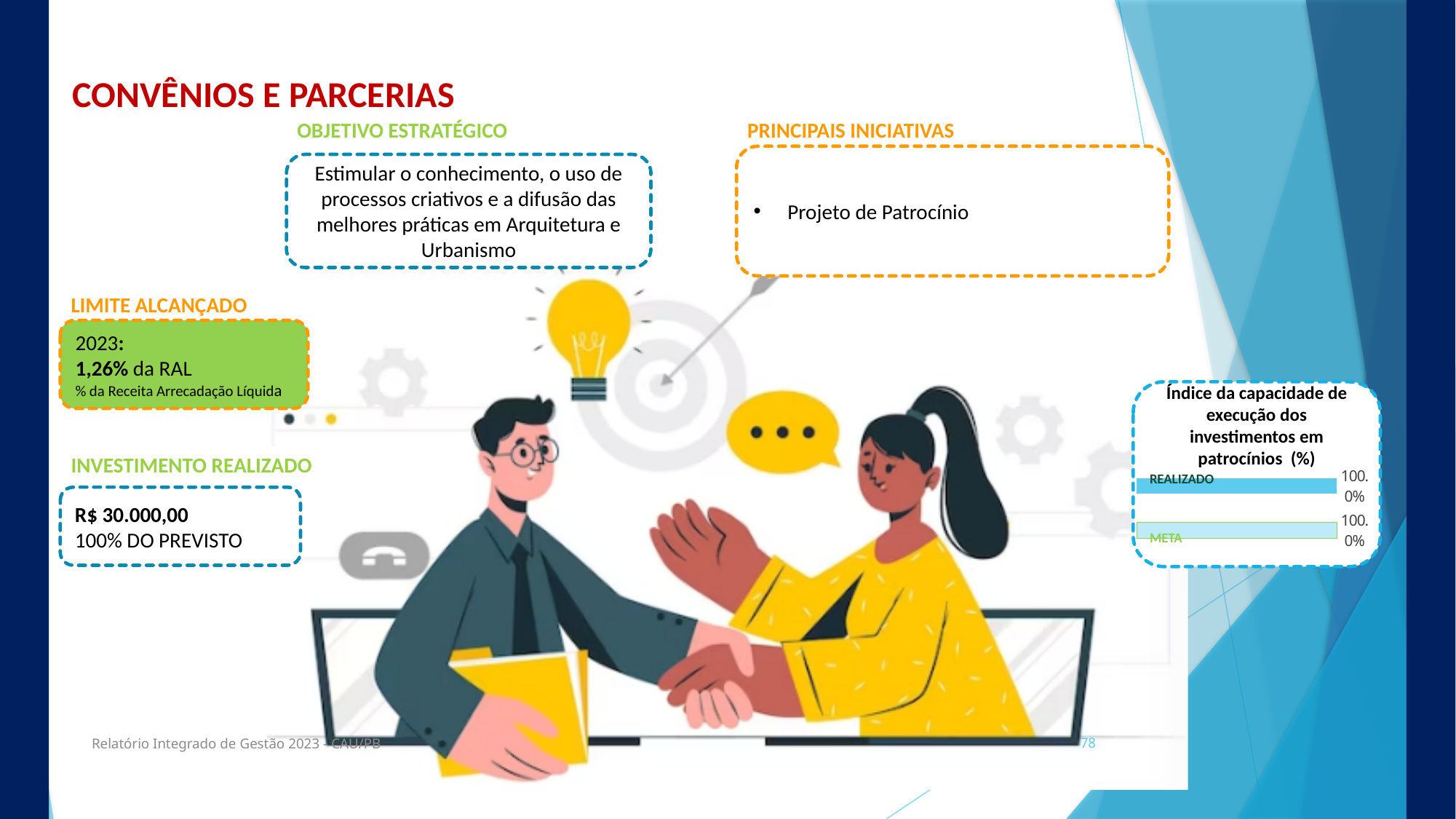
How many bars are plotted in the chart titled "Índice da capacidade de execução dos investimentos em patrocínios (%)"? 2 In the chart titled "Índice da capacidade de execução dos investimentos em patrocínios (%)", is the REALIZADO value greater or less than 50%? greater What is the title of the bar chart on the right side of the slide? Índice da capacidade de execução dos investimentos em patrocínios (%) What is the value of the REALIZADO bar in the chart titled "Índice da capacidade de execução dos investimentos em patrocínios (%)"? 100.0% What is the difference between the REALIZADO and META values in the chart titled "Índice da capacidade de execução dos investimentos em patrocínios (%)"? 0.0% What are the two category labels in the chart titled "Índice da capacidade de execução dos investimentos em patrocínios (%)"? REALIZADO and META What is the value of the META bar in the chart titled "Índice da capacidade de execução dos investimentos em patrocínios (%)"? 100.0% What kind of chart is the "Índice da capacidade de execução dos investimentos em patrocínios (%)" chart? Bar chart